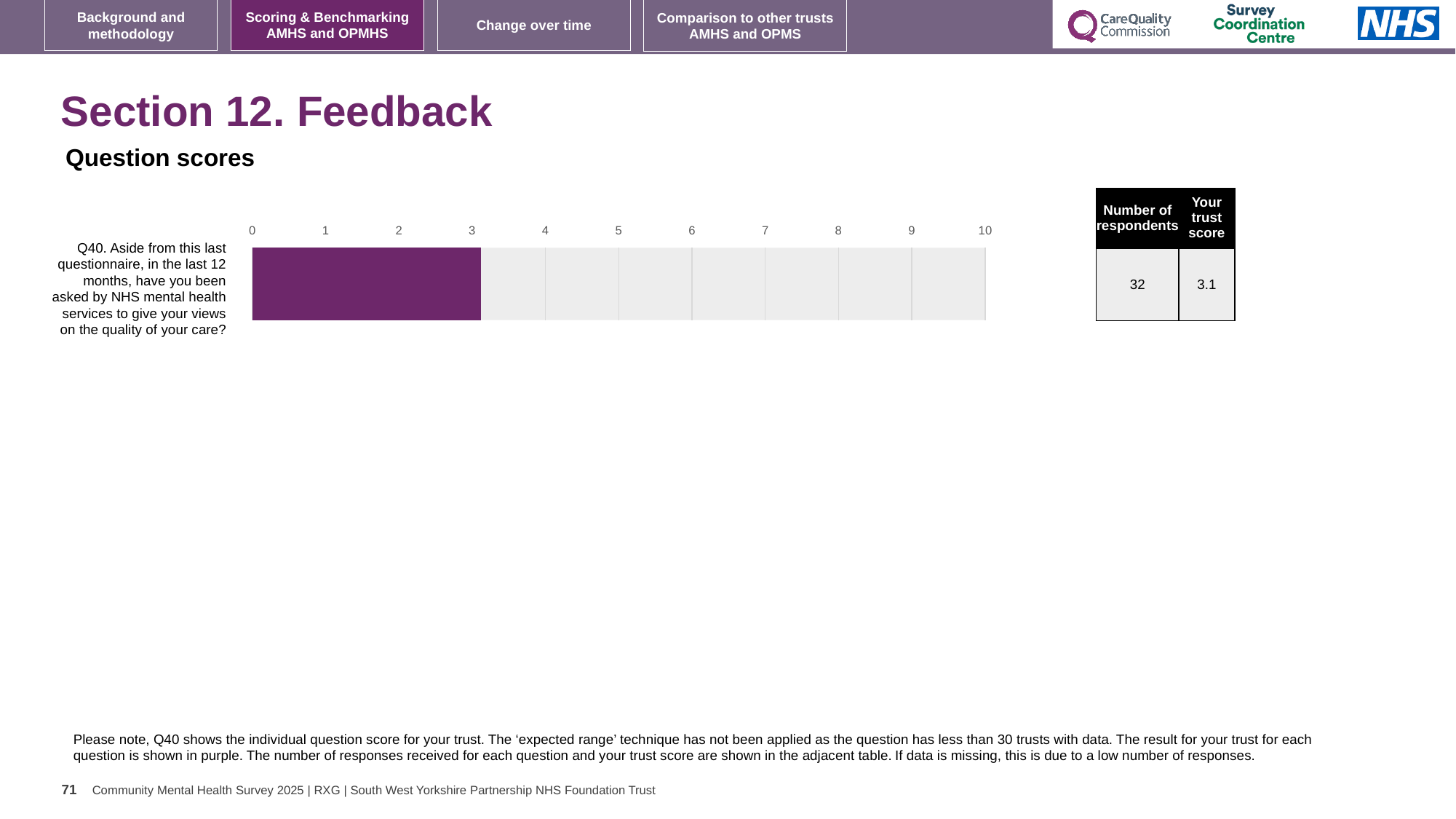
Is the value for Q40 greater or less than 5? less What colour is the bar showing the trust's result for Q40? purple Is the value for Q40 greater or less than 2? greater What is the maximum value shown on the chart's horizontal axis? 10 How many questions (bars) are plotted on the chart? 1 How many respondents answered Q40 according to the table next to the chart? 32 What kind of chart is used to show the Q40 question score? bar chart What is the trust score for Q40 shown on the slide? 3.1